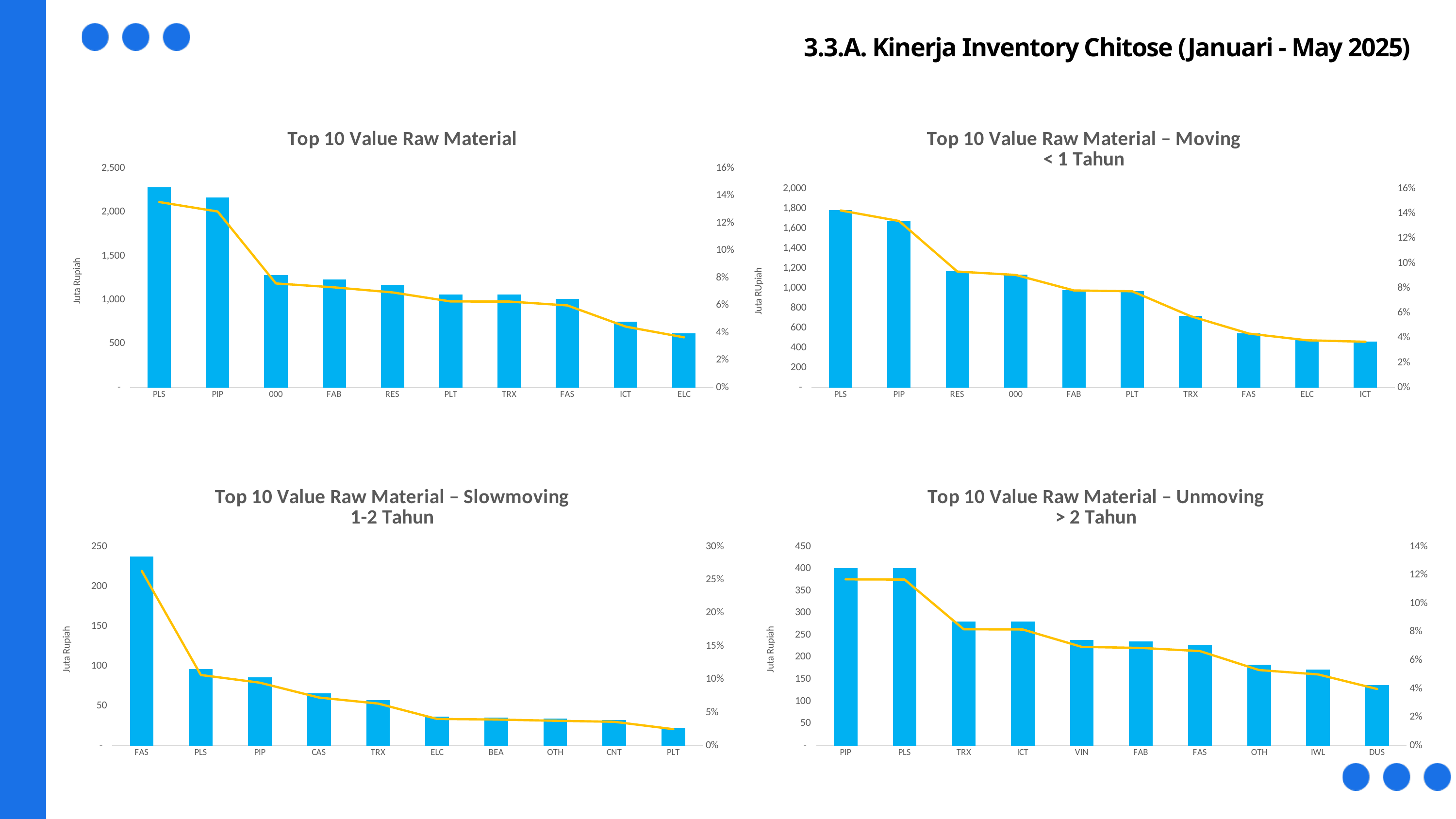
How many categories are shown on the x axis of the 'Top 10 Value Raw Material – Moving < 1 Tahun' chart (top right)? 10 In the 'Top 10 Value Raw Material' chart (top left), which category has the lowest bar? ELC In the 'Top 10 Value Raw Material – Moving < 1 Tahun' chart (top right), is the bar for TRX greater or less than 1,000? less In the 'Top 10 Value Raw Material – Slowmoving 1-2 Tahun' chart (bottom left), which category has the highest bar? FAS In the 'Top 10 Value Raw Material – Slowmoving 1-2 Tahun' chart (bottom left), which category has the lowest bar? PLT In the 'Top 10 Value Raw Material – Moving < 1 Tahun' chart (top right), which category has the highest bar? PLS In the 'Top 10 Value Raw Material' chart (top left), is the bar for PLS greater or less than 2,000? greater In the 'Top 10 Value Raw Material' chart (top left), which category has the highest bar? PLS In the 'Top 10 Value Raw Material – Unmoving > 2 Tahun' chart (bottom right), which category has the lowest bar? DUS What is the label on the vertical axis of the 'Top 10 Value Raw Material – Unmoving > 2 Tahun' chart (bottom right)? Juta Rupiah What kind of chart is the 'Top 10 Value Raw Material' chart at the top left? bar chart with a line In the 'Top 10 Value Raw Material – Slowmoving 1-2 Tahun' chart (bottom left), do the bar values rise or fall from left to right along the x axis? fall